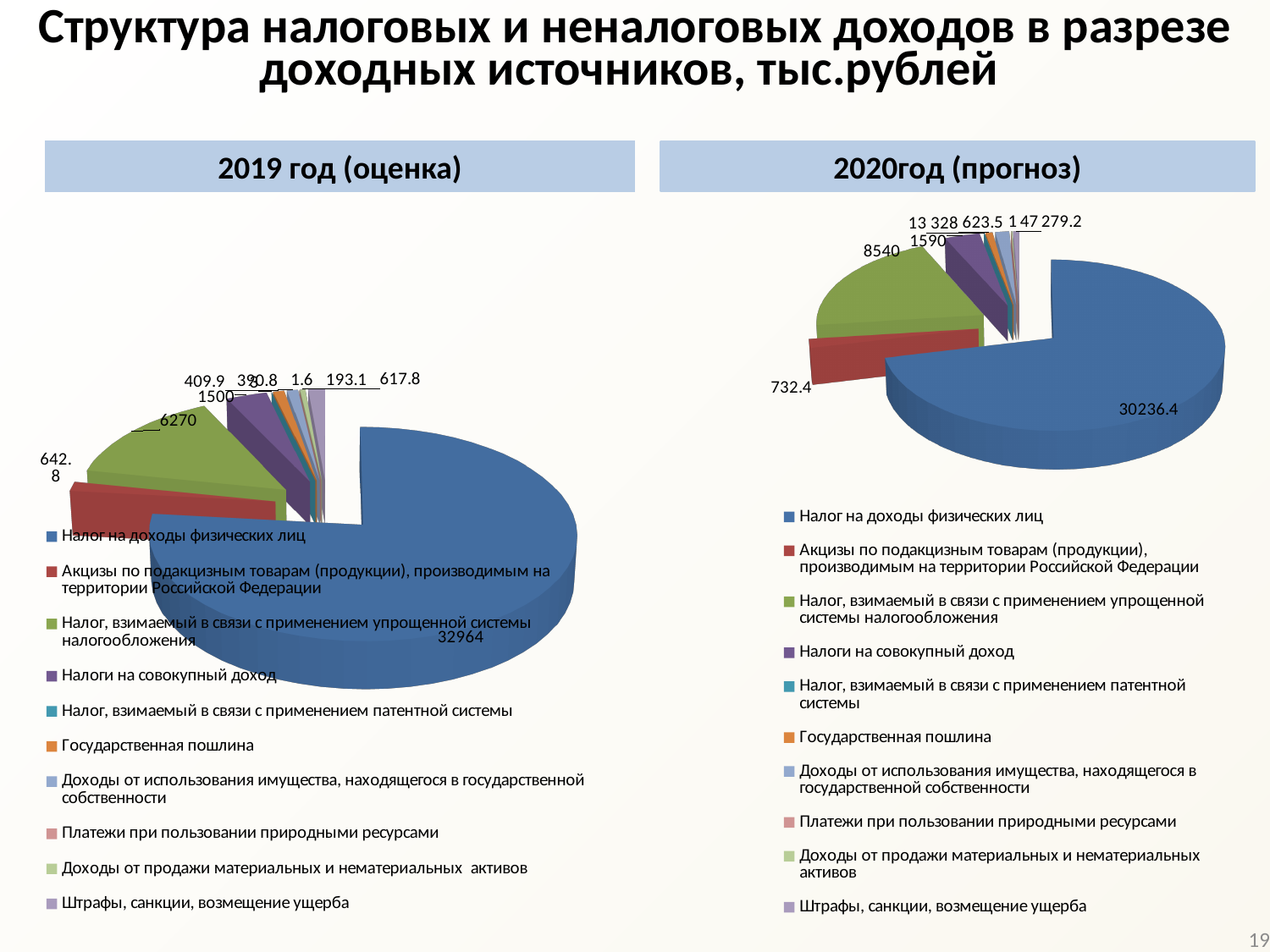
In the 2019 год (оценка) chart, what is the value for Налог на доходы физических лиц? 32964 What is the difference between the Налог на доходы физических лиц value in the 2019 год (оценка) chart and in the 2020год (прогноз) chart? 2727.6 In the 2020год (прогноз) chart, what is the value for Налог на доходы физических лиц? 30236.4 In the 2020год (прогноз) chart, what is the value for Налог, взимаемый в связи с применением упрощенной системы налогообложения? 8540 Is the value for Налог, взимаемый в связи с применением упрощенной системы налогообложения larger in the 2019 год (оценка) chart or in the 2020год (прогноз) chart? 2020год (прогноз) In the 2019 год (оценка) chart, what is the value for Налог, взимаемый в связи с применением упрощенной системы налогообложения? 6270 How many categories does the legend of the 2020год (прогноз) chart list? 10 In the 2019 год (оценка) chart, what is the value for Акцизы по подакцизным товарам (продукции), производимым на территории Российской Федерации? 642.8 In the 2020год (прогноз) chart, what is the value for Акцизы по подакцизным товарам (продукции), производимым на территории Российской Федерации? 732.4 In the 2020год (прогноз) chart, what is the value for Налоги на совокупный доход? 1590 What kind of chart is used on the slide for the 2019 год (оценка) data? Pie chart In the 2019 год (оценка) chart, which category has the largest slice? Налог на доходы физических лиц